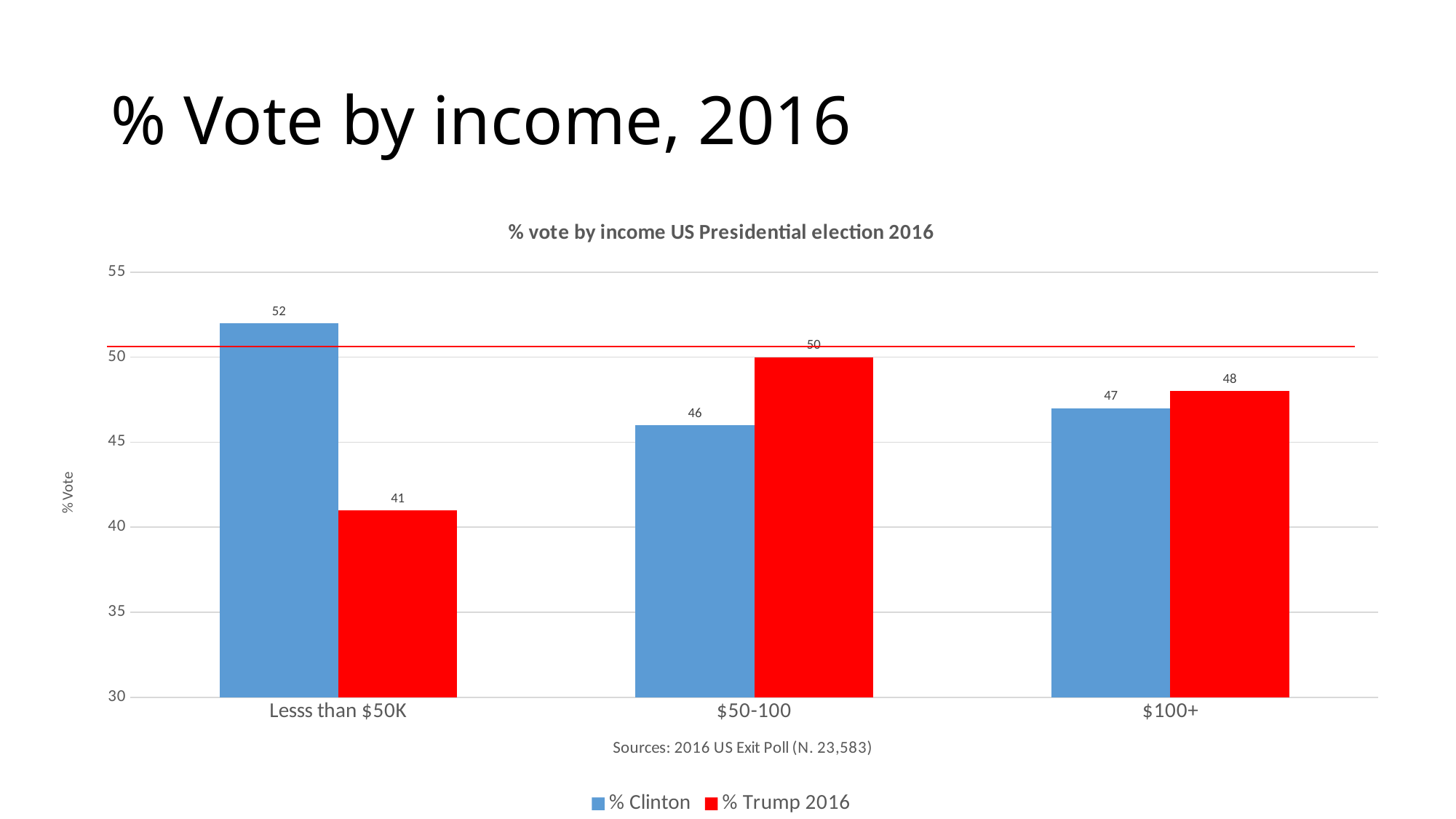
What is the % Trump 2016 value for the '$100+' income group? 48 Which income group has the lowest % Trump 2016 value? Lesss than $50K Which income group has the highest % Clinton value? Lesss than $50K What is the % Trump 2016 value for the '$50-100' income group? 50 What kind of chart is shown on the slide? Bar chart What is the difference between the % Clinton and % Trump 2016 values for the 'Lesss than $50K' group? 11 What is the title of the chart? % vote by income US Presidential election 2016 For the '$50-100' income group, which is larger: % Clinton or % Trump 2016? % Trump 2016 Is the % Trump 2016 value for 'Lesss than $50K' greater or less than 45? less What is the % Clinton value for the 'Lesss than $50K' income group? 52 How many income groups are shown on the x axis? 3 How many series does the legend list? 2